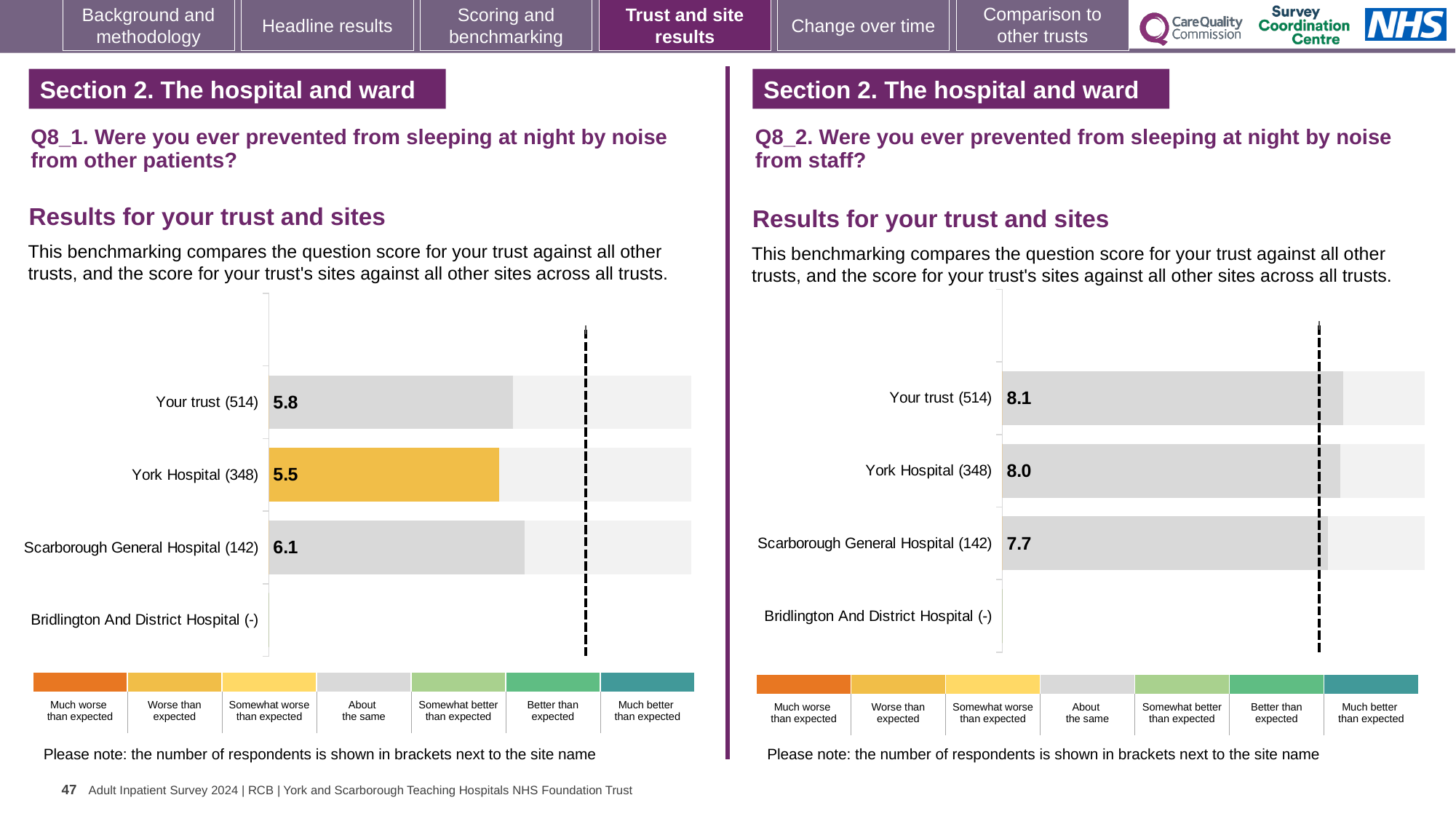
In the Q8_2 chart (noise from staff), what is the score for Scarborough General Hospital (142)? 7.7 In the Q8_1 chart (noise from other patients), what is the difference between the scores for Scarborough General Hospital and York Hospital? 0.6 In the Q8_2 chart (noise from staff), what is the difference between the scores for Your trust and Scarborough General Hospital? 0.4 In the Q8_1 chart (noise from other patients), what is the score for York Hospital (348)? 5.5 In the Q8_2 chart (noise from staff), which row has the lowest score among those with a value shown? Scarborough General Hospital (142) In the Q8_1 chart (noise from other patients), what is the score for Your trust (514)? 5.8 In the Q8_1 chart (noise from other patients), which site or trust row has the highest score? Scarborough General Hospital (142) In the Q8_1 chart (noise from other patients), what is the score for Scarborough General Hospital (142)? 6.1 In the Q8_1 chart (noise from other patients), which bar is coloured yellow/orange rather than grey? York Hospital (348) In the Q8_2 chart (noise from staff), is the score for Your trust or York Hospital larger? Your trust What kind of chart is used in the Q8_1 chart (noise from other patients)? Bar chart In the Q8_2 chart (noise from staff), what is the score for Your trust (514)? 8.1